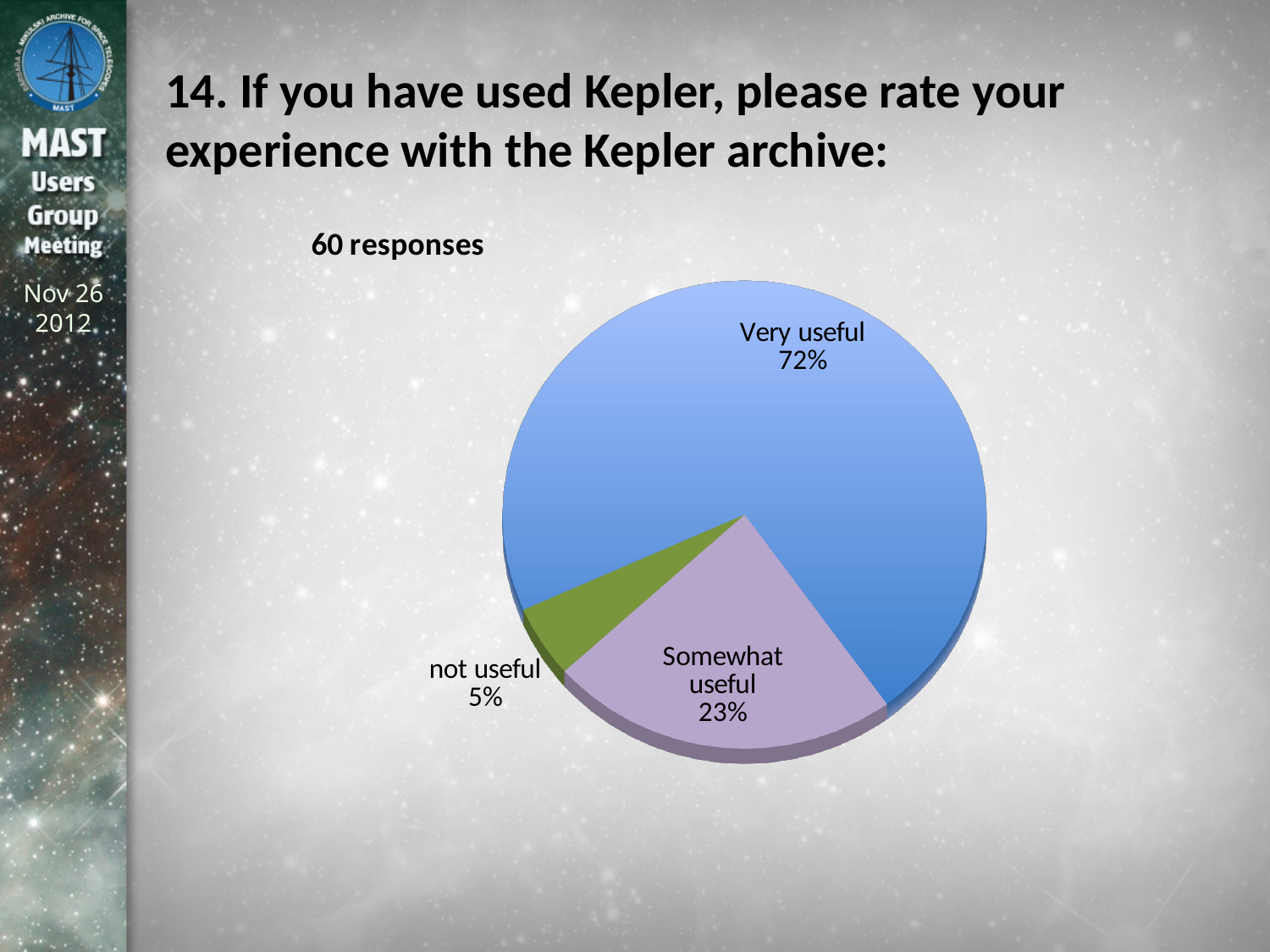
Which rating category has the largest share of the pie? Very useful What percentage of respondents rated the Kepler archive as Very useful? 72% What is the combined share of the Somewhat useful and not useful slices? 28% What is the difference in percentage points between the Very useful and Somewhat useful slices? 49 Which rating category has the smallest share of the pie? not useful How many responses does the slide say the chart is based on? 60 responses What percentage of respondents rated the Kepler archive as not useful? 5% What percentage of respondents rated the Kepler archive as Somewhat useful? 23% Which slice is larger, Somewhat useful or not useful? Somewhat useful How many slices does the pie chart have? 3 What colour is the Very useful slice of the pie? blue What kind of chart is shown on the slide? pie chart